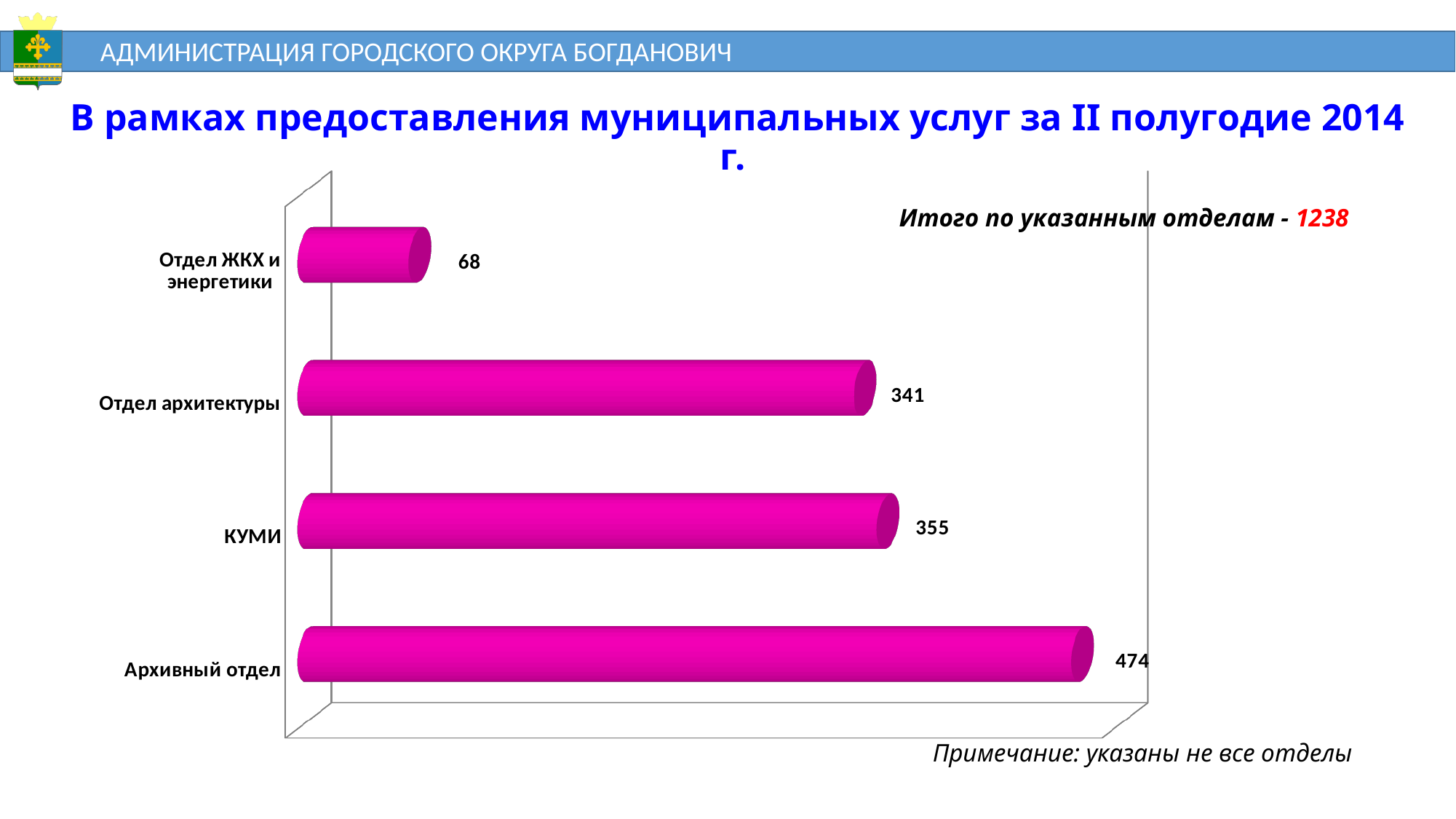
What is the value for Архивный отдел? 474 What is the difference between the values for Отдел архитектуры and Отдел ЖКХ и энергетики? 273 Which is larger, the value for КУМИ or the value for Отдел архитектуры? КУМИ What is the value for Отдел ЖКХ и энергетики? 68 What kind of chart is shown on the slide? Bar chart How many departments are shown in the chart? 4 Which department has the lowest value? Отдел ЖКХ и энергетики Which department has the highest value? Архивный отдел What total for the listed departments is stated on the slide? 1238 What is the difference between the values for Архивный отдел and КУМИ? 119 What is the value for КУМИ? 355 What is the value for Отдел архитектуры? 341